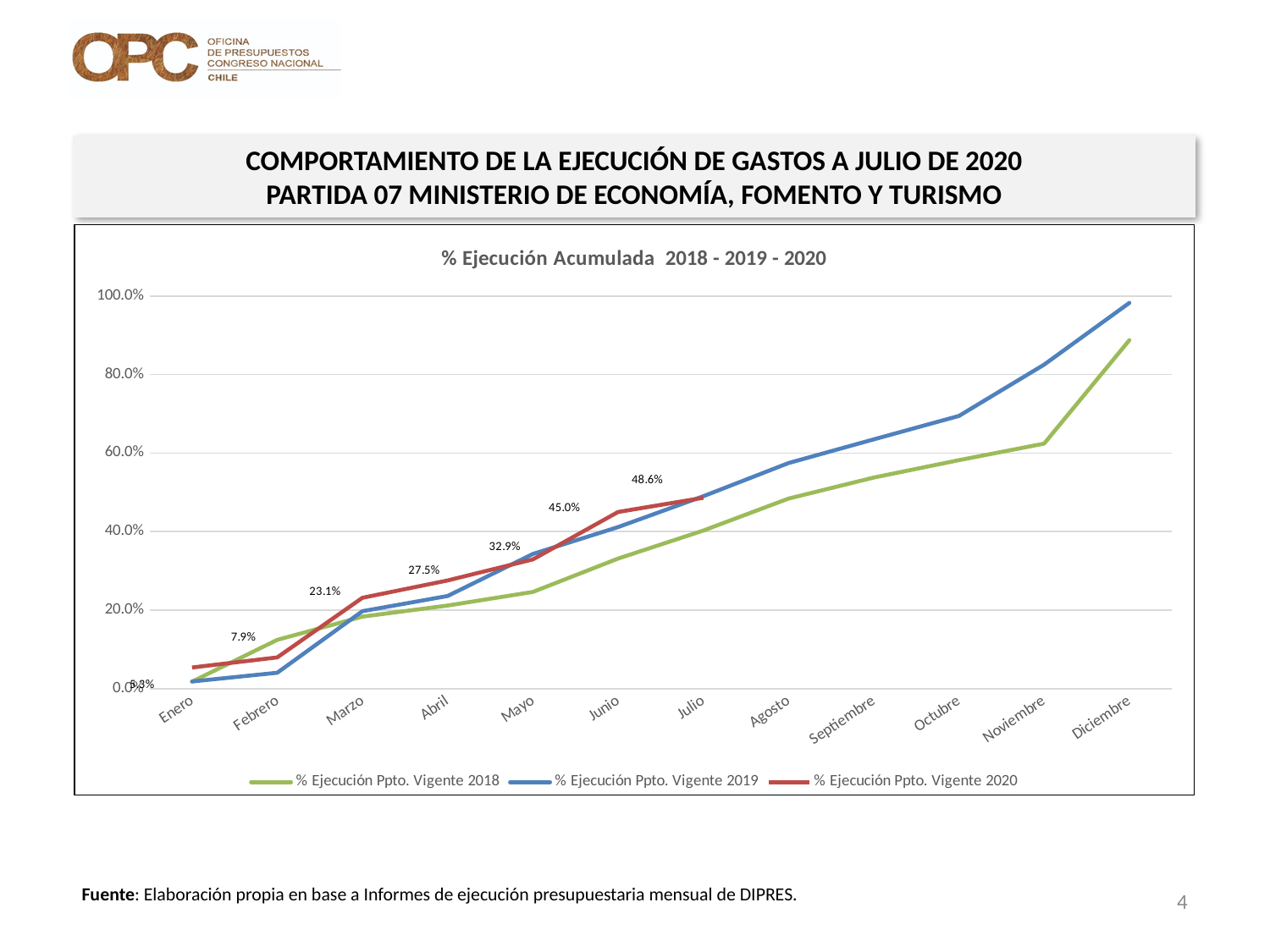
What is the title of the chart? % Ejecución Acumulada 2018 - 2019 - 2020 Which series has the higher value in Diciembre, % Ejecución Ppto. Vigente 2018 or % Ejecución Ppto. Vigente 2019? % Ejecución Ppto. Vigente 2019 What is the value for % Ejecución Ppto. Vigente 2020 in Julio? 48.6% What is the value for % Ejecución Ppto. Vigente 2020 in Marzo? 23.1% How many series does the legend list? 3 Is the value for % Ejecución Ppto. Vigente 2019 in Diciembre greater or less than 80.0%? greater What is the difference between the 2020 values for Marzo and Febrero? 15.2% What is the difference between the 2020 values for Julio and Junio? 3.6% What is the value for % Ejecución Ppto. Vigente 2020 in Junio? 45.0% What is the value for % Ejecución Ppto. Vigente 2020 in Mayo? 32.9% What kind of chart is shown on the slide? Line chart How many months are shown on the x axis? 12